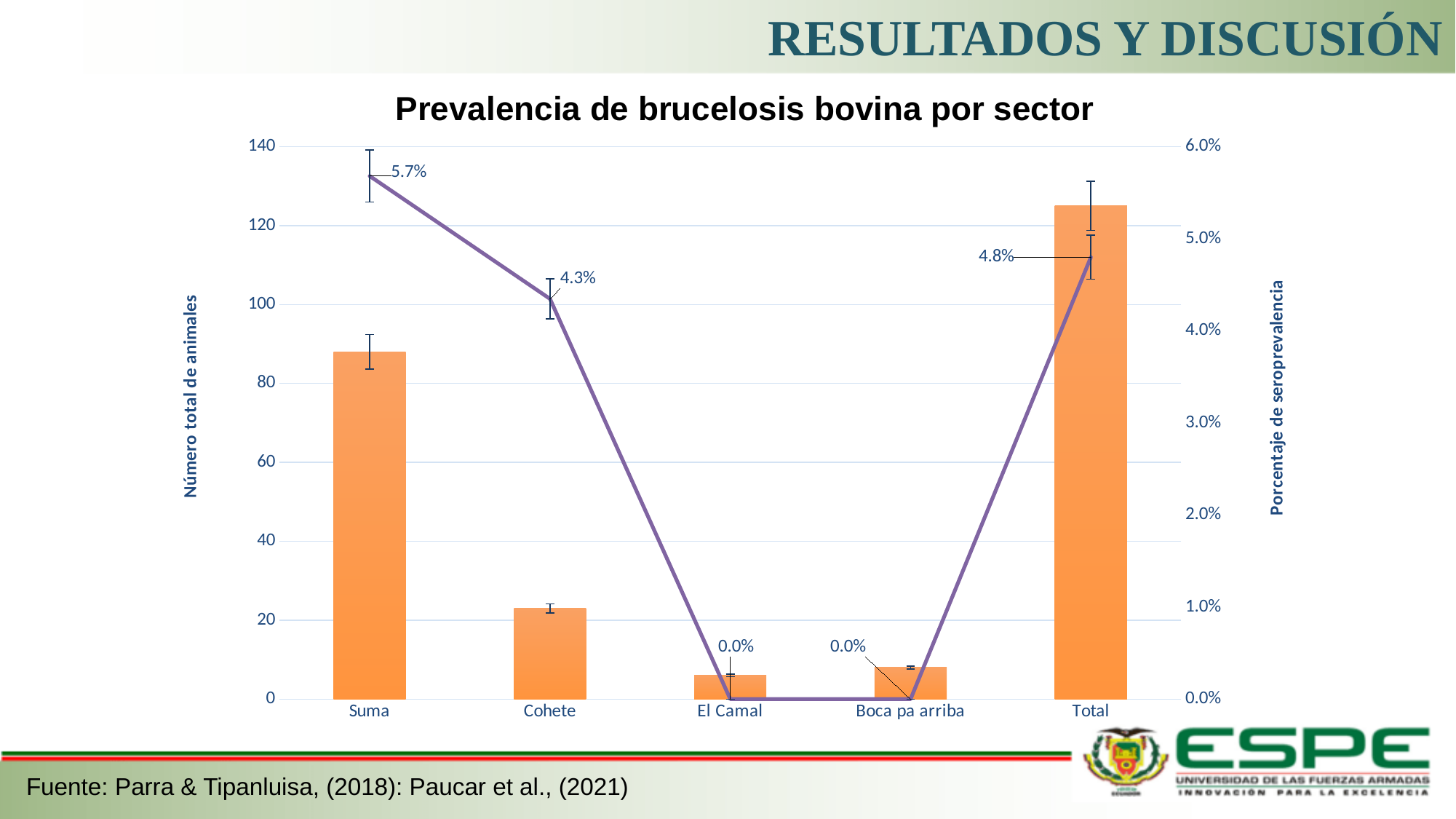
Which category has the highest seroprevalence percentage on the line? Suma Is the number of animals bar for Total greater or less than 120? greater What is the seroprevalence percentage shown for Total? 4.8% Which has a higher seroprevalence percentage, Cohete or Total? Total What is the title of the chart? Prevalencia de brucelosis bovina por sector What is the difference between the seroprevalence percentages of Suma and Cohete? 1.4% How many categories are shown on the x axis? 5 What is the seroprevalence percentage shown for Suma? 5.7% Is the number of animals bar for Cohete greater or less than 40? less Is the number of animals bar for Suma greater or less than 80? greater What is the seroprevalence percentage shown for El Camal? 0.0% What is the seroprevalence percentage shown for Cohete? 4.3%